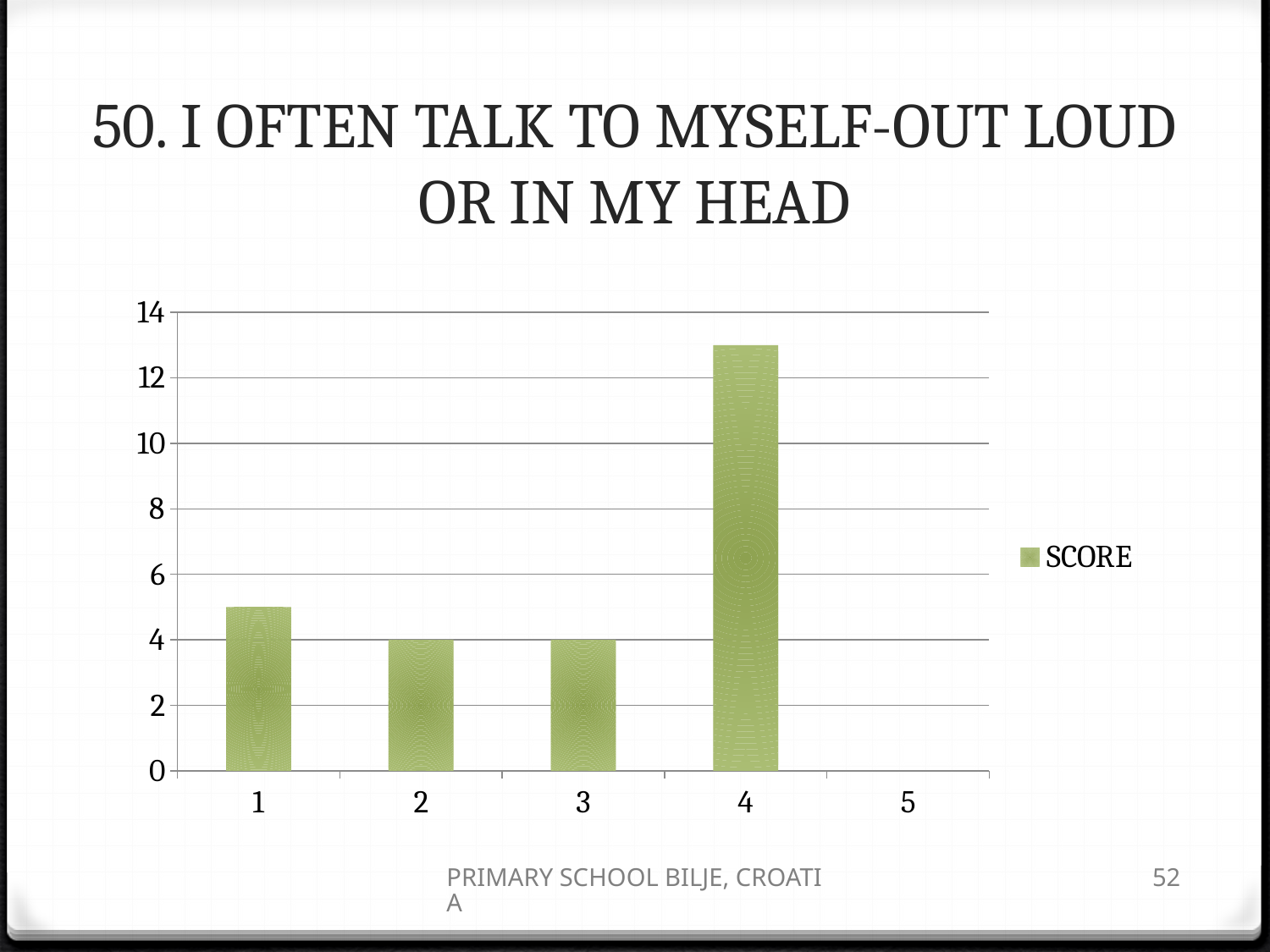
Which category has the lowest SCORE? 5 What is the SCORE value for category 5? 0 What is the SCORE value for category 2? 4 How many series does the legend list? 1 Is the SCORE value for category 4 greater or less than 12? greater What is the SCORE value for category 3? 4 What is the difference between the SCORE values for category 2 and category 3? 0 Is the SCORE value for category 1 greater or less than 6? less How many categories are shown on the x axis? 5 Which category has the highest SCORE? 4 What kind of chart is shown on the slide? bar chart Which has a larger SCORE, category 1 or category 4? category 4